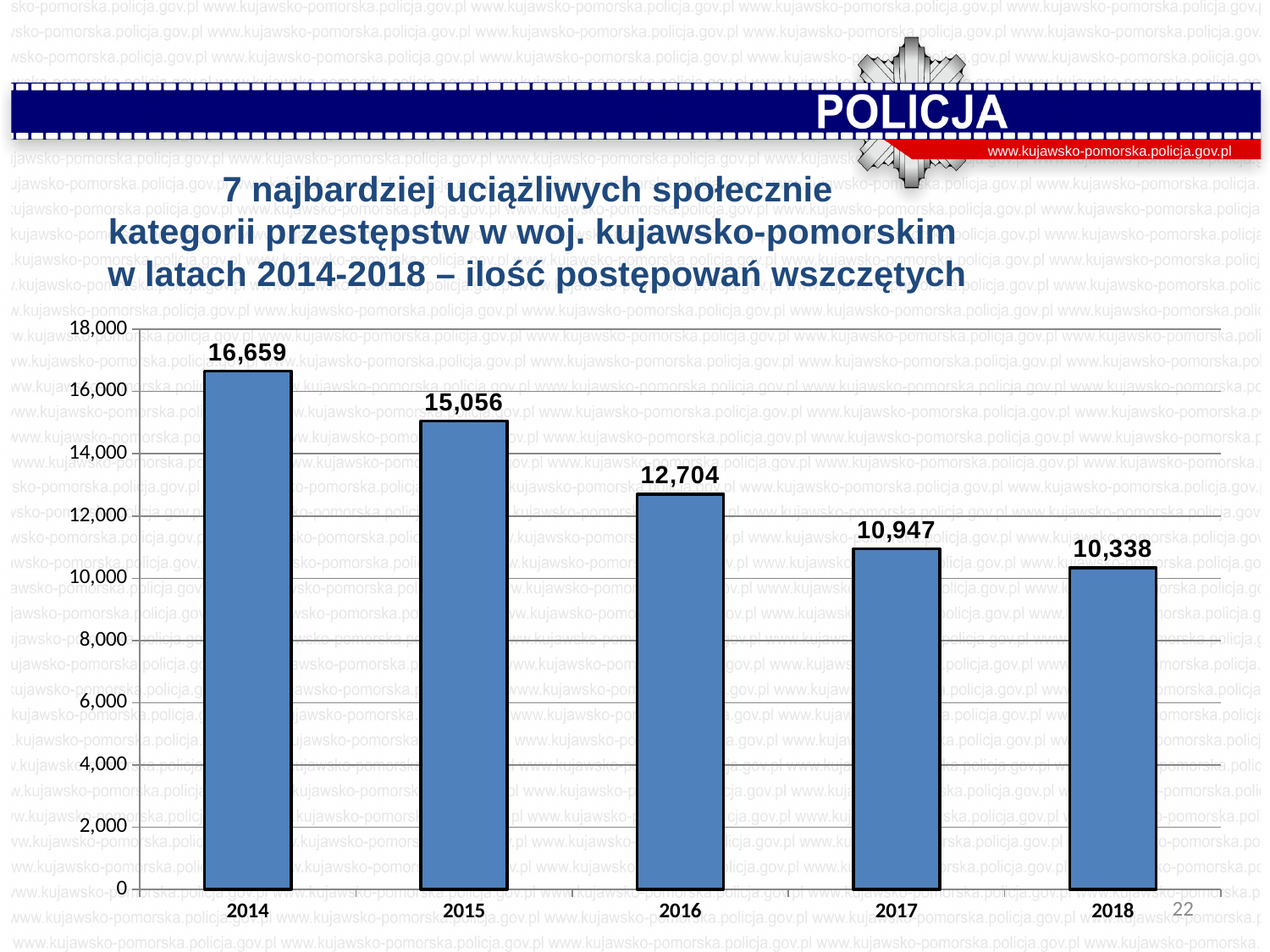
What is the difference between the values for 2014 and 2018? 6,321 What is the difference between the values for 2015 and 2016? 2,352 Is the value for 2017 greater or less than 12,000? less What is the value for 2016? 12,704 Which year has the lowest value? 2018 Do the values rise or fall from 2014 to 2018? fall What is the value for 2018? 10,338 What is the value for 2014? 16,659 How many years are shown on the x axis? 5 What kind of chart is shown on the slide? bar chart Which year has the highest value? 2014 Which is larger, the value for 2015 or the value for 2017? 2015